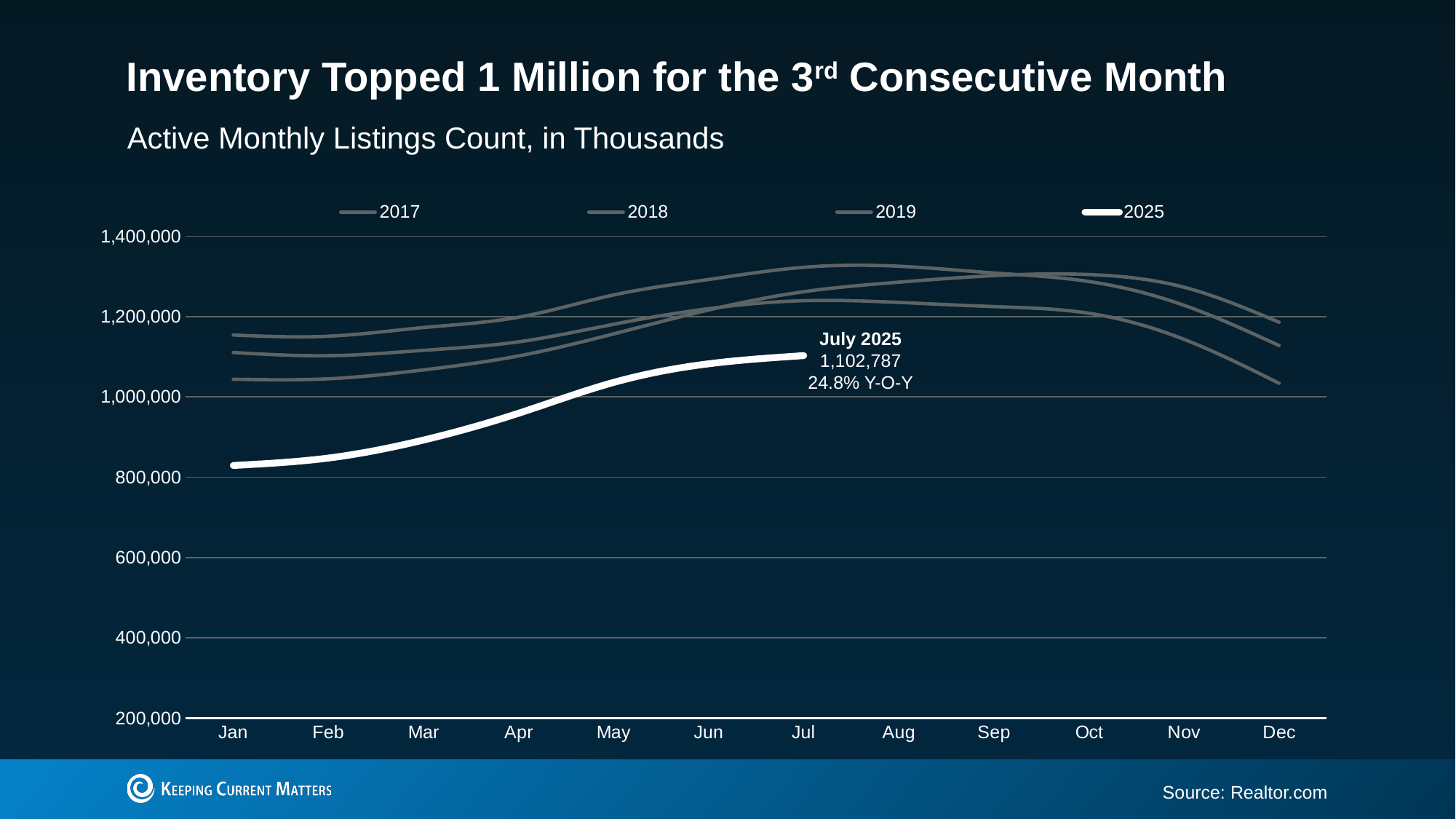
What kind of chart is shown on the slide? line chart What year-over-year change is labelled for July 2025? 24.8% Y-O-Y Is the value for 2025 in Jan greater or less than 800,000? greater Which month has the highest value on the 2025 line? Jul How many months are labelled along the x axis? 12 Is the value for 2025 in Jul greater or less than 1,000,000? greater What is the subtitle describing what the chart measures? Active Monthly Listings Count, in Thousands What is the labelled value for July 2025? 1,102,787 Is the value for 2025 in Jan greater or less than 1,000,000? less Does the 2025 line rise or fall from Jan to Jul? rise Which month has the lowest value on the 2025 line? Jan How many series does the legend list? 4